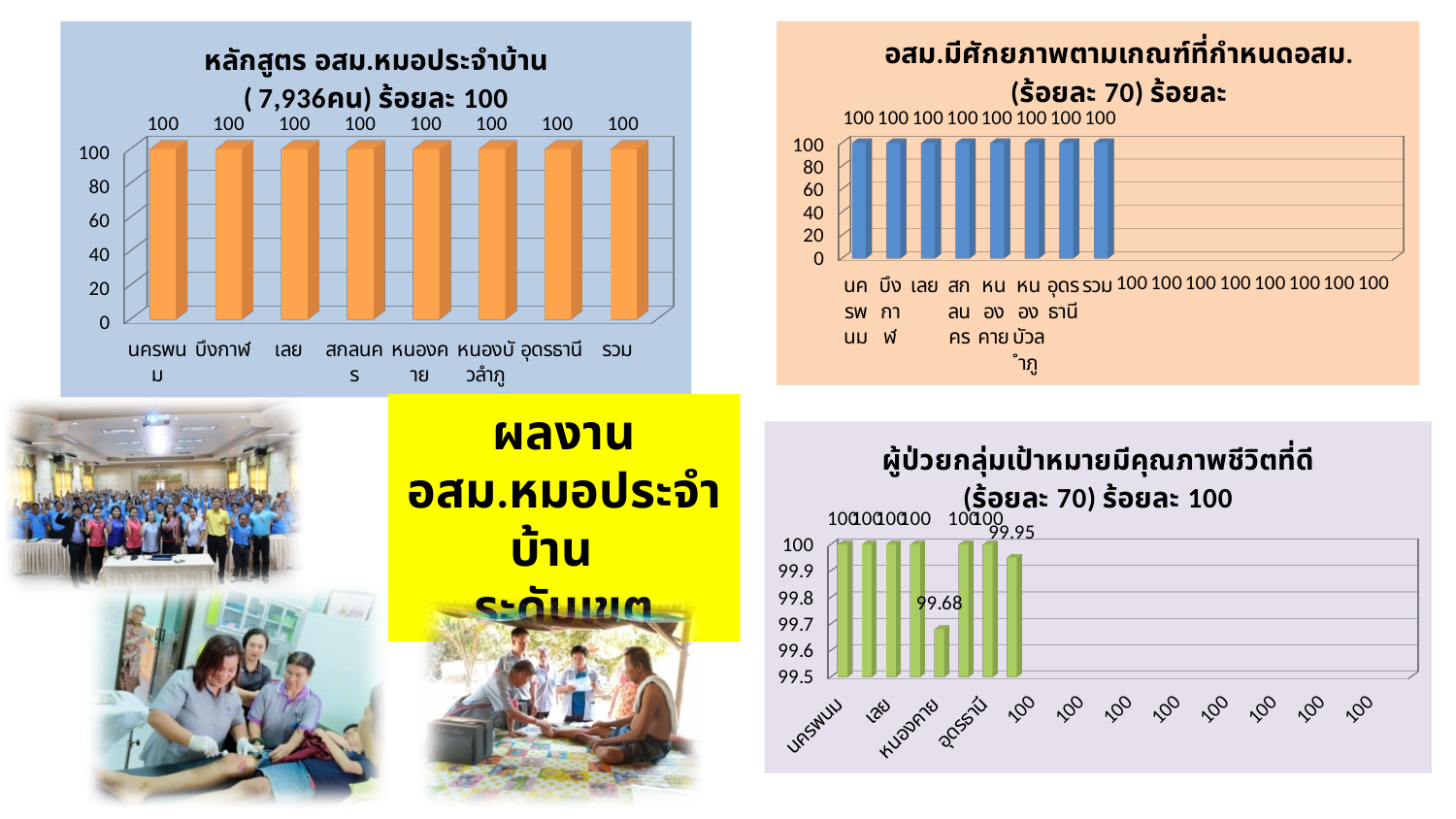
In the bottom-right chart titled 'ผู้ป่วยกลุ่มเป้าหมายมีคุณภาพชีวิตที่ดี', what is the difference between the values for นครพนม and หนองคาย? 0.32 In the bottom-right chart titled 'ผู้ป่วยกลุ่มเป้าหมายมีคุณภาพชีวิตที่ดี', which labelled category has the lowest value? หนองคาย In the chart titled 'หลักสูตร อสม.หมอประจำบ้าน ( 7,936คน) ร้อยละ 100', what is the value for รวม? 100 In the chart titled 'หลักสูตร อสม.หมอประจำบ้าน ( 7,936คน) ร้อยละ 100', what is the value for เลย? 100 In the chart titled 'หลักสูตร อสม.หมอประจำบ้าน ( 7,936คน) ร้อยละ 100', how many bars are plotted? 8 In the bottom-right chart titled 'ผู้ป่วยกลุ่มเป้าหมายมีคุณภาพชีวิตที่ดี', what is the value for หนองคาย? 99.68 In the bottom-right chart titled 'ผู้ป่วยกลุ่มเป้าหมายมีคุณภาพชีวิตที่ดี', which is larger, the value for เลย or the value for หนองคาย? เลย In the bottom-right chart titled 'ผู้ป่วยกลุ่มเป้าหมายมีคุณภาพชีวิตที่ดี', what is the value for นครพนม? 100 What kind of chart is the top-left chart titled 'หลักสูตร อสม.หมอประจำบ้าน'? bar chart In the top-right chart titled 'อสม.มีศักยภาพตามเกณฑ์ที่กำหนดอสม.', what is the value for อุดรธานี? 100 In the top-right chart titled 'อสม.มีศักยภาพตามเกณฑ์ที่กำหนดอสม.', how many bars are plotted? 8 In the top-right chart titled 'อสม.มีศักยภาพตามเกณฑ์ที่กำหนดอสม.', what colour are the bars? blue